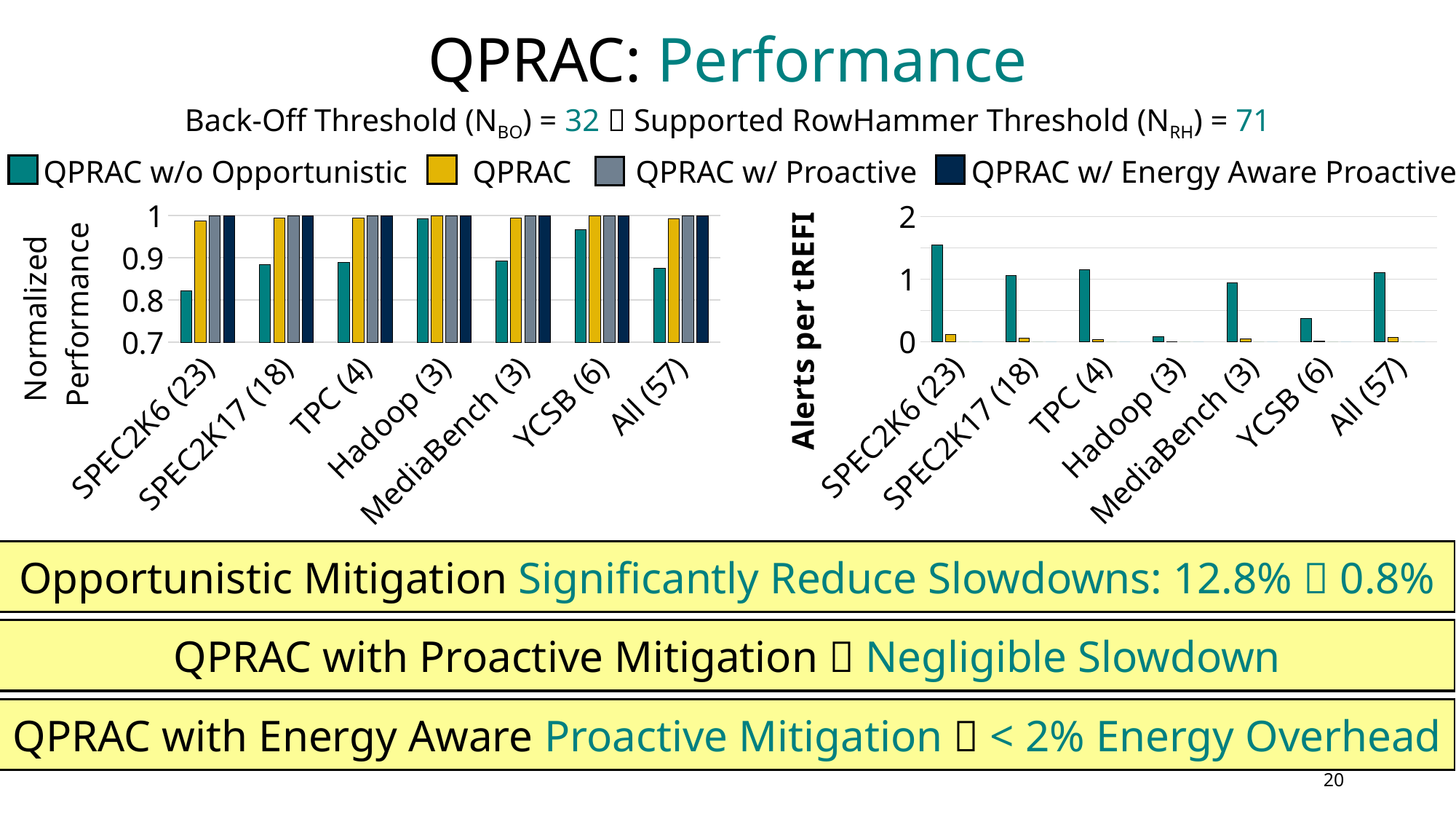
In the Alerts per tREFI chart on the right, which category has the lowest QPRAC w/o Opportunistic value? Hadoop (3) In the Alerts per tREFI chart on the right, which category has the highest QPRAC w/o Opportunistic value? SPEC2K6 (23) In the Normalized Performance chart on the left, which category has the lowest QPRAC w/o Opportunistic value? SPEC2K6 (23) What is the y-axis title of the chart on the right? Alerts per tREFI How many series does the legend list? 4 How many workload categories are shown on the x axis of the Alerts per tREFI chart on the right? 7 In the Alerts per tREFI chart on the right, is the QPRAC w/o Opportunistic value for YCSB (6) greater or less than 1? less What kind of chart is the Normalized Performance chart on the left? bar chart In the Normalized Performance chart on the left, which is larger for QPRAC w/o Opportunistic: Hadoop (3) or SPEC2K6 (23)? Hadoop (3) In the Alerts per tREFI chart on the right, is the QPRAC w/o Opportunistic value for SPEC2K6 (23) greater or less than 1? greater In the Normalized Performance chart on the left, is the QPRAC w/o Opportunistic value for SPEC2K6 (23) greater or less than 0.9? less In the Alerts per tREFI chart on the right, which is larger for QPRAC w/o Opportunistic: SPEC2K6 (23) or YCSB (6)? SPEC2K6 (23)